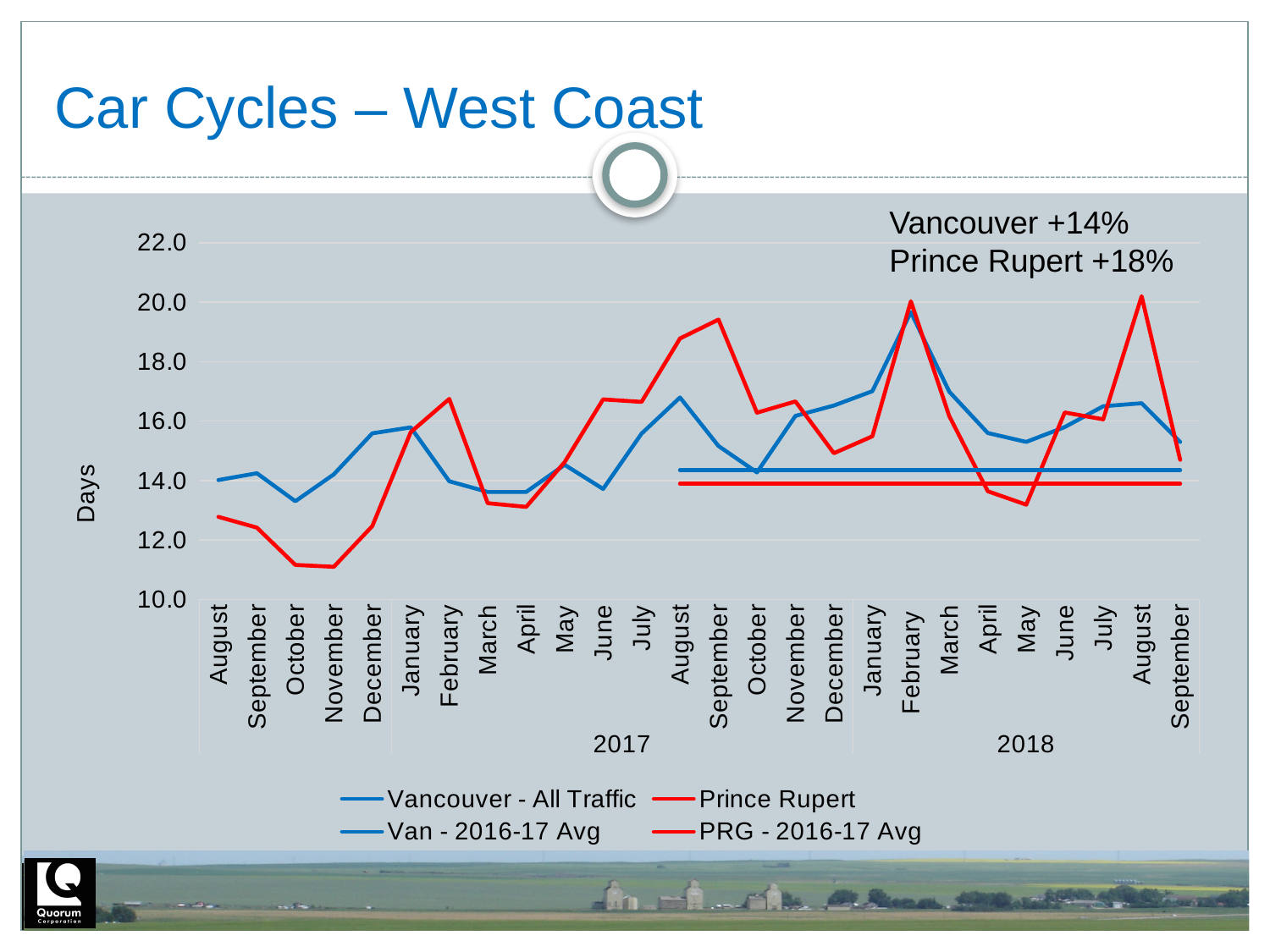
Is the Prince Rupert value for November 2016 greater or less than 12.0? less What percentage change is shown for Prince Rupert in the annotation on the chart? +18% Is the Vancouver - All Traffic value for October 2016 greater or less than 14.0? less Is the Prince Rupert value for September 2017 greater or less than 18.0? greater In which month does the Vancouver - All Traffic series reach its highest value? February 2018 How many monthly points are plotted along the x axis? 26 In November 2016, which series is higher: Vancouver - All Traffic or Prince Rupert? Vancouver - All Traffic What is the label on the y axis? Days What kind of chart is shown on the slide? line chart How many series does the legend list? 4